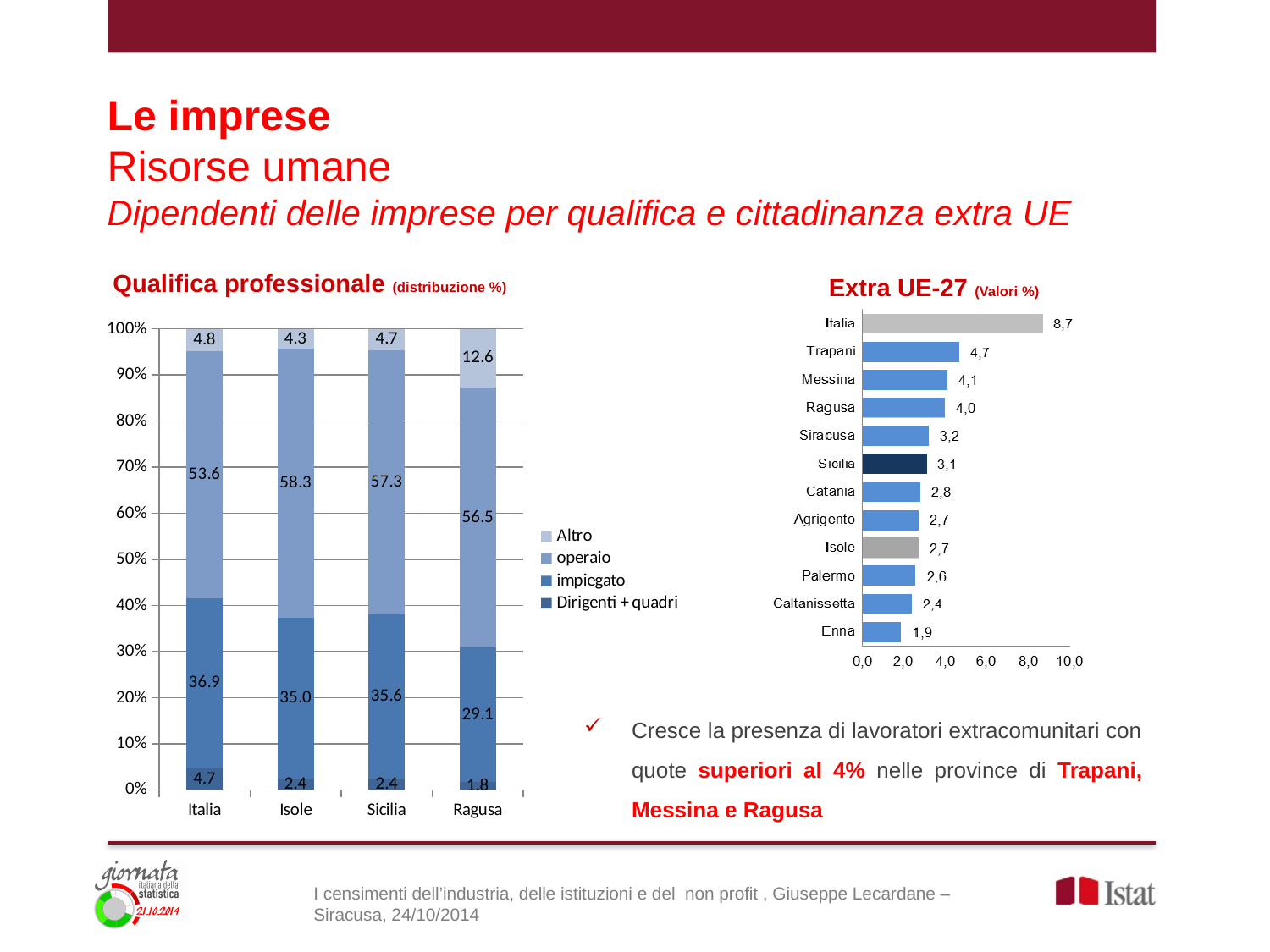
In the 'Extra UE-27' chart, which category has the highest value? Italia In the 'Qualifica professionale' chart, what is the operaio value for Isole? 58.3 What kind of chart is the 'Qualifica professionale' chart? Stacked bar chart In the 'Extra UE-27' chart, what is the difference between the values for Italia and Sicilia? 5,6 In the 'Qualifica professionale' chart, which category has the highest Dirigenti + quadri value? Italia In the 'Qualifica professionale' chart, is the impiegato value larger for Italia or for Ragusa? Italia In the 'Qualifica professionale' chart, what is the Altro value for Ragusa? 12.6 In the 'Extra UE-27' chart, how many categories are shown? 12 In the 'Extra UE-27' chart, what is the value for Trapani? 4,7 In the 'Extra UE-27' chart, which category has the lowest value? Enna In the 'Qualifica professionale' chart, how many series does the legend list? 4 In the 'Extra UE-27' chart, is the value for Messina greater or less than 4,0? greater